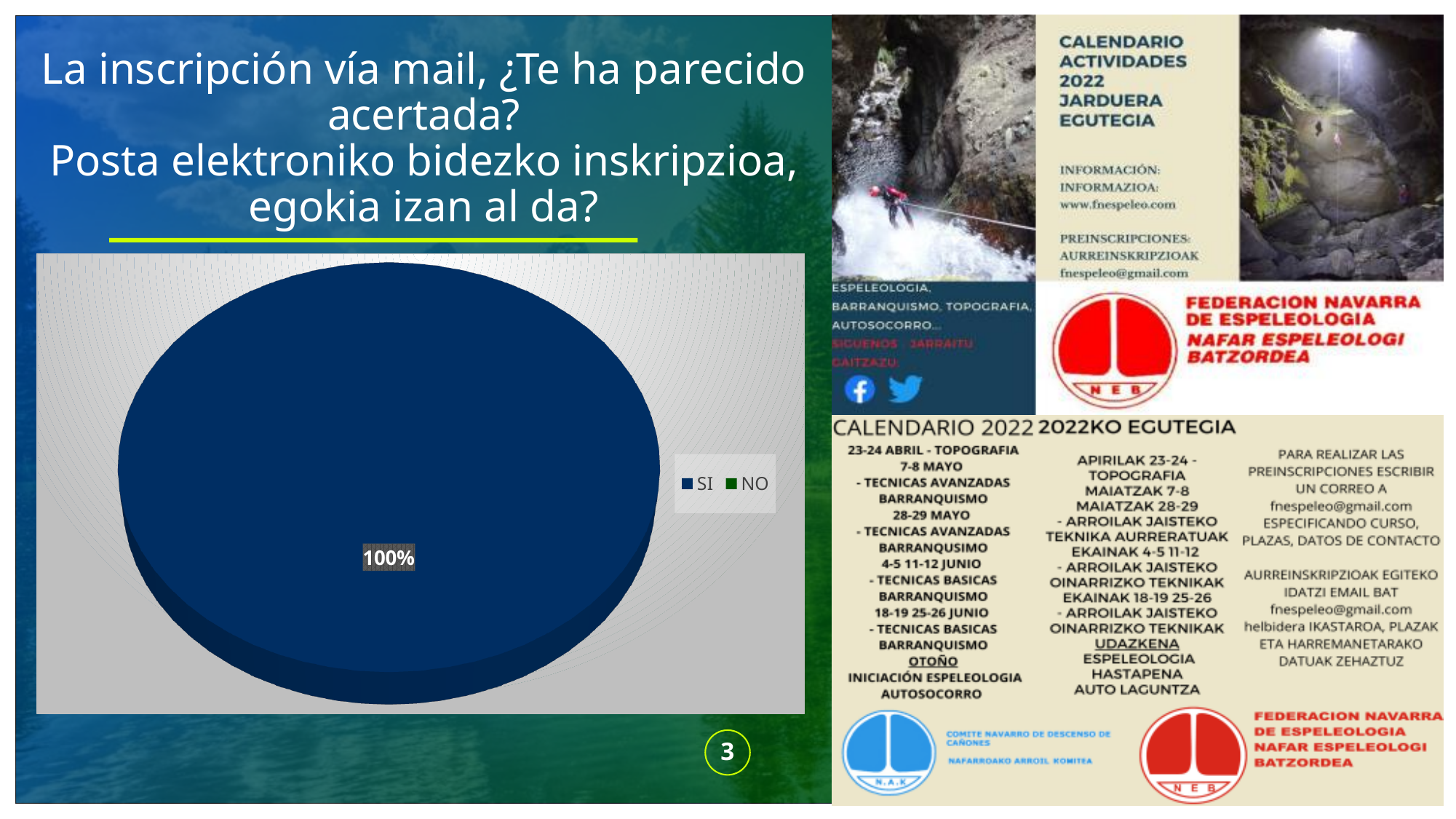
How many entries does the legend of the pie chart list? 2 What kind of chart is shown on the slide? pie chart What colour is the SI slice in the pie chart? dark blue What percentage is shown for the SI slice of the pie chart? 100% Which category has the largest share of the pie chart? SI Is the share for SI in the pie chart greater or less than 50%? greater What share of the pie does the SI category take? 100% Which is larger in the pie chart, SI or NO? SI Which category has the smallest share of the pie chart? NO What are the two categories listed in the legend of the pie chart? SI and NO